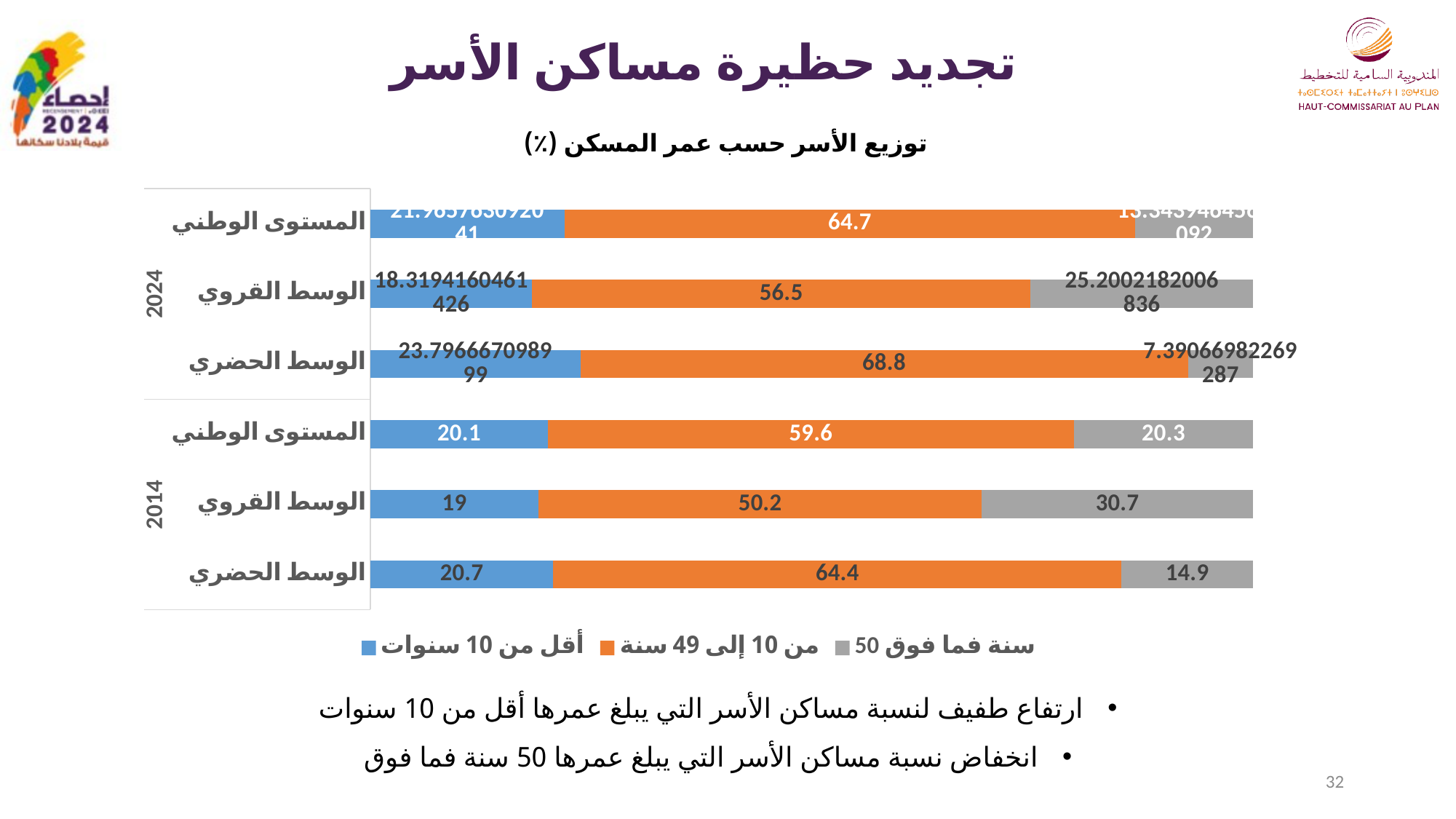
What is the total of the stacked bar for المستوى الوطني in 2014? 100 What is the value of the 'من 10 إلى 49 سنة' series for الوسط الحضري in 2024? 68.8 What is the value of the 'أقل من 10 سنوات' series for المستوى الوطني in 2014? 20.1 Which is larger: the '50 سنة فما فوق' value for الوسط القروي in 2014 or for المستوى الوطني in 2014? الوسط القروي in 2014 What is the value of the '50 سنة فما فوق' series for الوسط القروي in 2014? 30.7 What type of chart is shown on the slide? Stacked bar chart Among the 2014 bars, which category has the highest value for the '50 سنة فما فوق' series? الوسط القروي Among the 2024 bars, which category has the lowest value for the 'من 10 إلى 49 سنة' series? الوسط القروي How many series does the legend list? 3 What is the value of the 'من 10 إلى 49 سنة' series for الوسط الحضري in 2014? 64.4 What is the difference between the 'من 10 إلى 49 سنة' values for الوسط الحضري in 2024 and in 2014? 4.4 What is the value of the 'من 10 إلى 49 سنة' series for الوسط القروي in 2024? 56.5